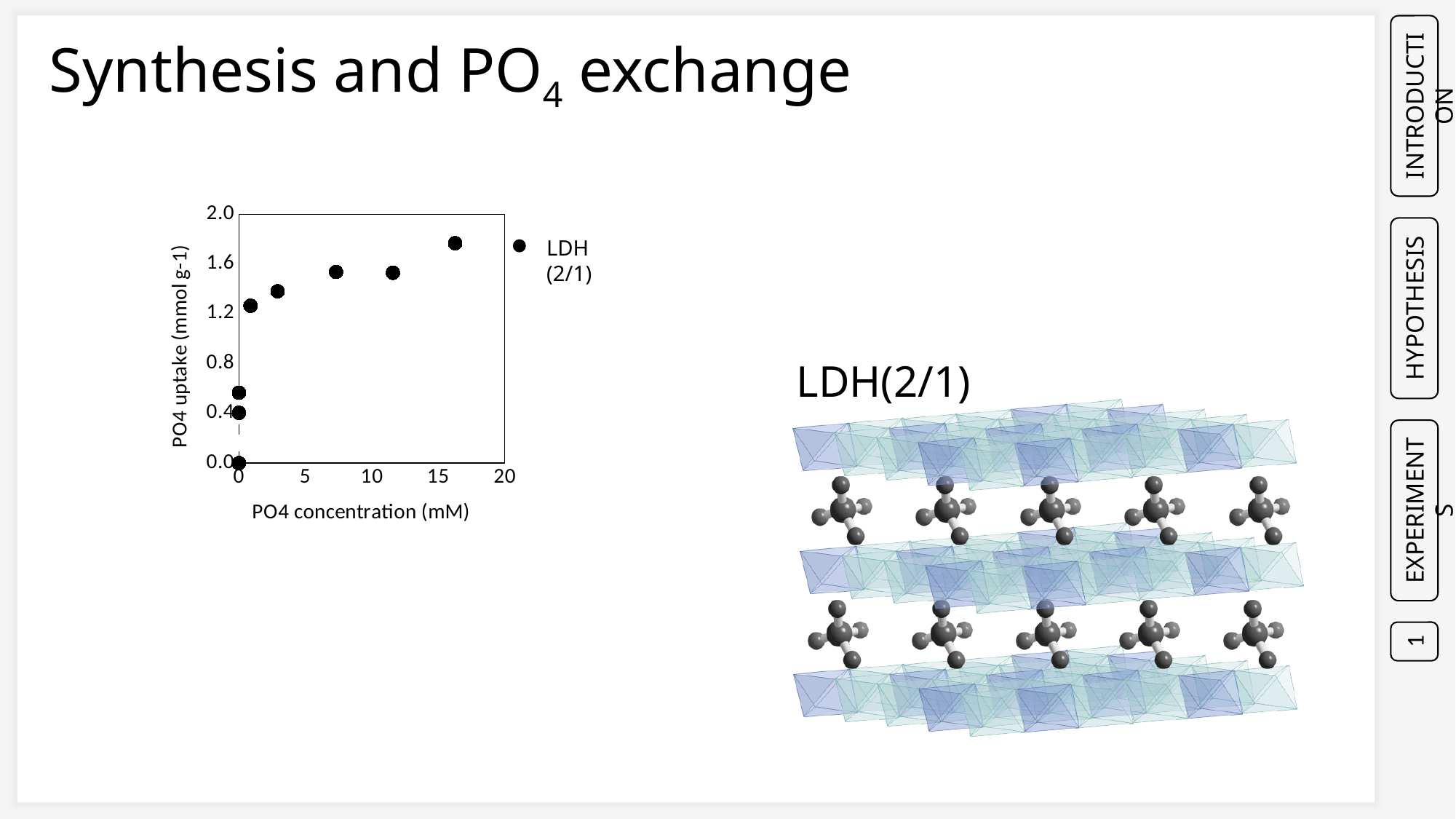
Is the PO4 concentration of the point with the highest PO4 uptake greater or less than 15 mM? greater How many series does the chart legend list? 1 Is the PO4 uptake for the point at about 1 mM PO4 concentration greater or less than 1.2? greater What kind of chart is shown on the slide? scatter chart Is the PO4 uptake for the point at the highest PO4 concentration (around 16 mM) greater or less than 1.6? greater Which has the higher PO4 uptake: the point at about 16 mM or the point at about 7 mM PO4 concentration? the point at about 16 mM What is the title of the y axis of the chart? PO4 uptake (mmol g-1) Do the PO4 uptake values generally rise or fall as PO4 concentration increases along the x axis? rise What is the name of the series shown in the chart legend? LDH (2/1) How many data points are plotted in the chart? 8